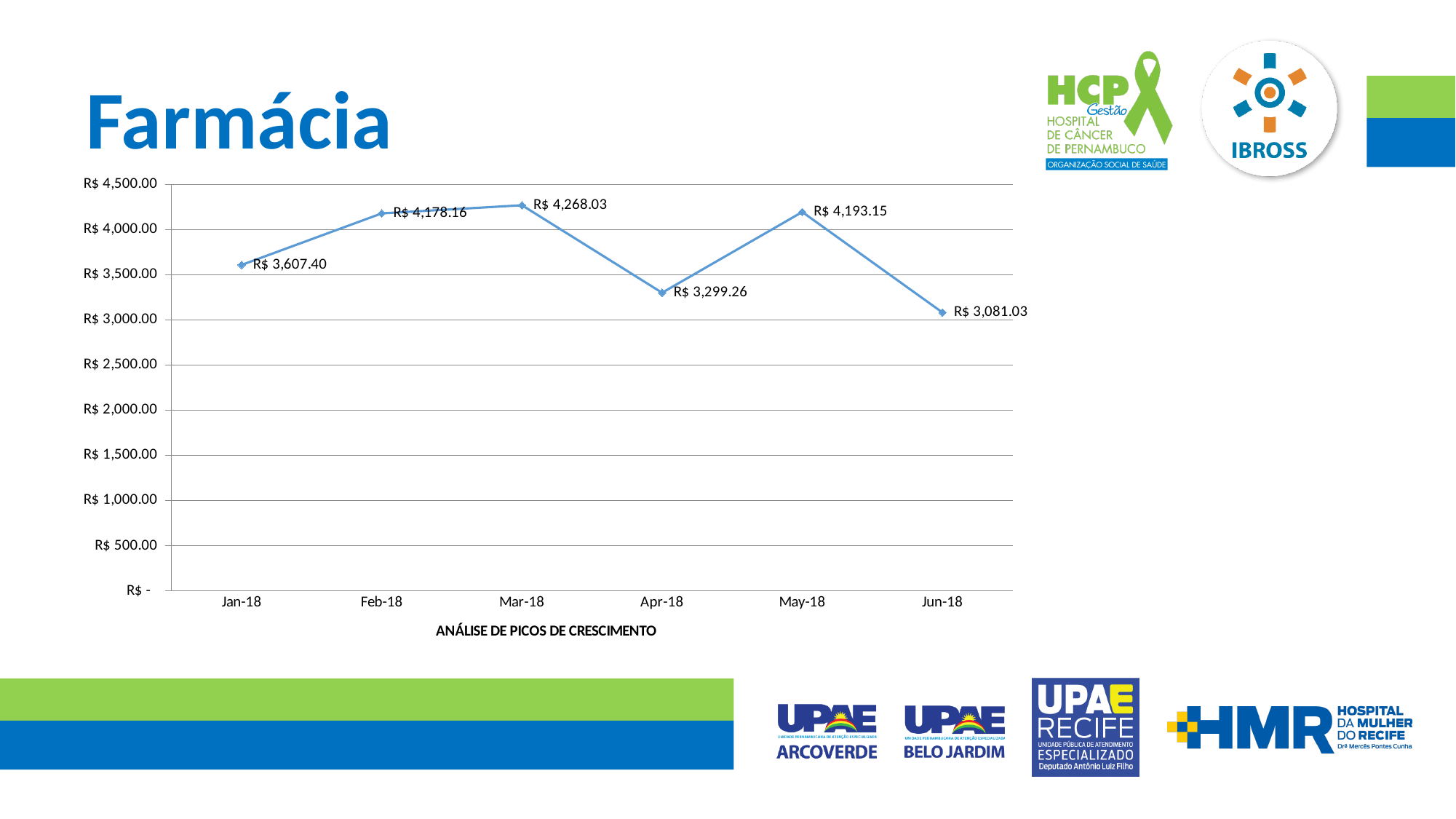
Which is larger, the value for Feb-18 or the value for May-18? May-18 What kind of chart is shown on the slide? line chart What is the value for Apr-18? R$ 3,299.26 What is the difference between the values for May-18 and Jun-18? R$ 1,112.12 What is the value for May-18? R$ 4,193.15 Is the value for Apr-18 greater or less than R$ 3,500.00? less Which month has the highest value? Mar-18 Which month has the lowest value? Jun-18 How many months are plotted on the chart? 6 What is the difference between the values for Mar-18 and Jan-18? R$ 660.63 Between Mar-18 and Apr-18, does the value rise or fall? fall What is the value for Jan-18? R$ 3,607.40